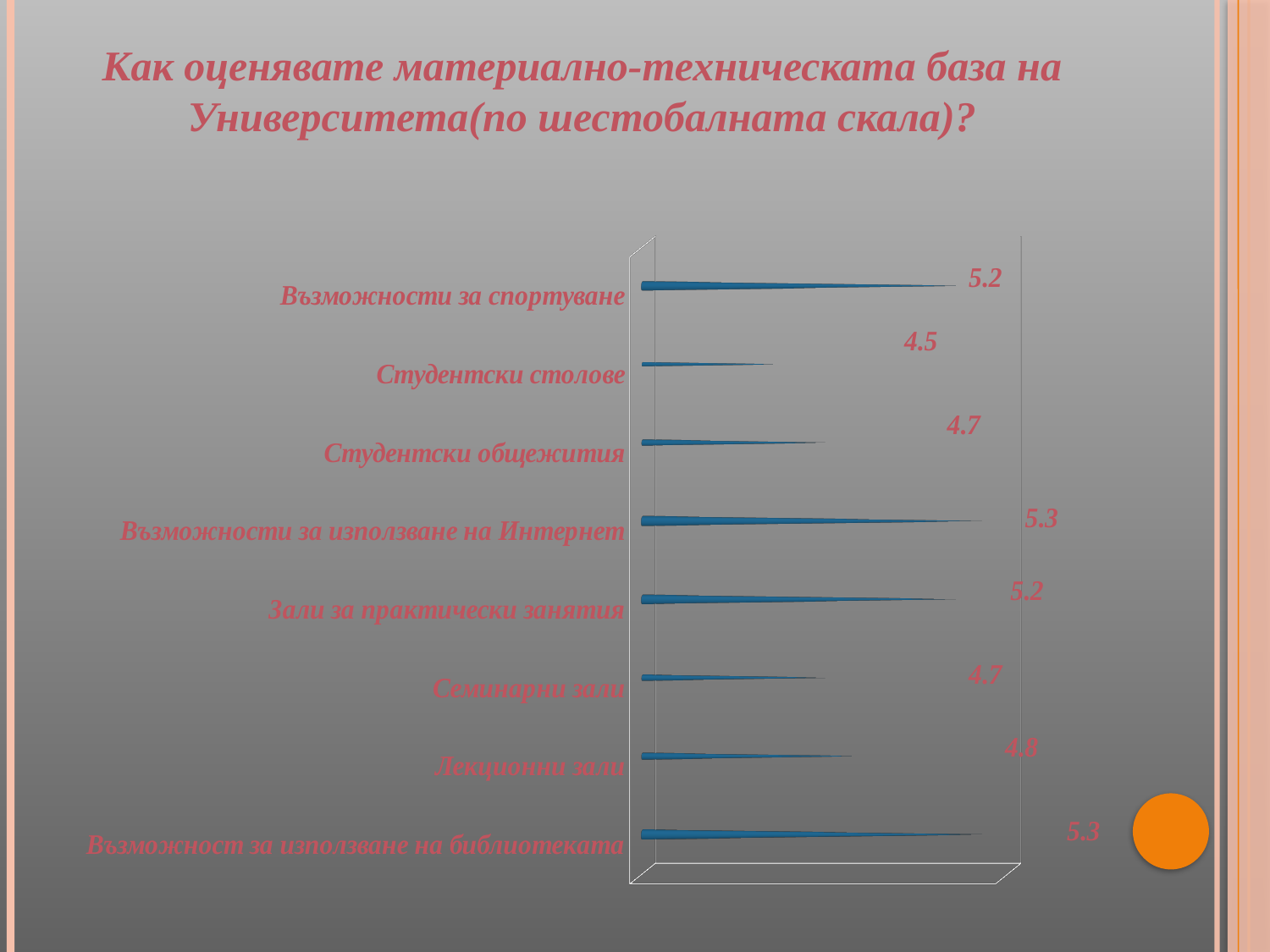
What value is shown for Възможности за спортуване? 5.2 Which category has the lowest value? Студентски столове How many categories are shown in the chart? 8 What kind of chart is shown on the slide? Bar chart What value is shown for Възможност за използване на библиотеката? 5.3 What value is shown for Семинарни зали? 4.7 Which has a larger value, Лекционни зали or Студентски столове? Лекционни зали What value is shown for Лекционни зали? 4.8 What value is shown for Студентски столове? 4.5 What is the difference between the values for Възможности за използване на Интернет and Студентски столове? 0.8 What is the difference between the values for Зали за практически занятия and Студентски общежития? 0.5 Which has a larger value, Възможност за използване на библиотеката or Семинарни зали? Възможност за използване на библиотеката